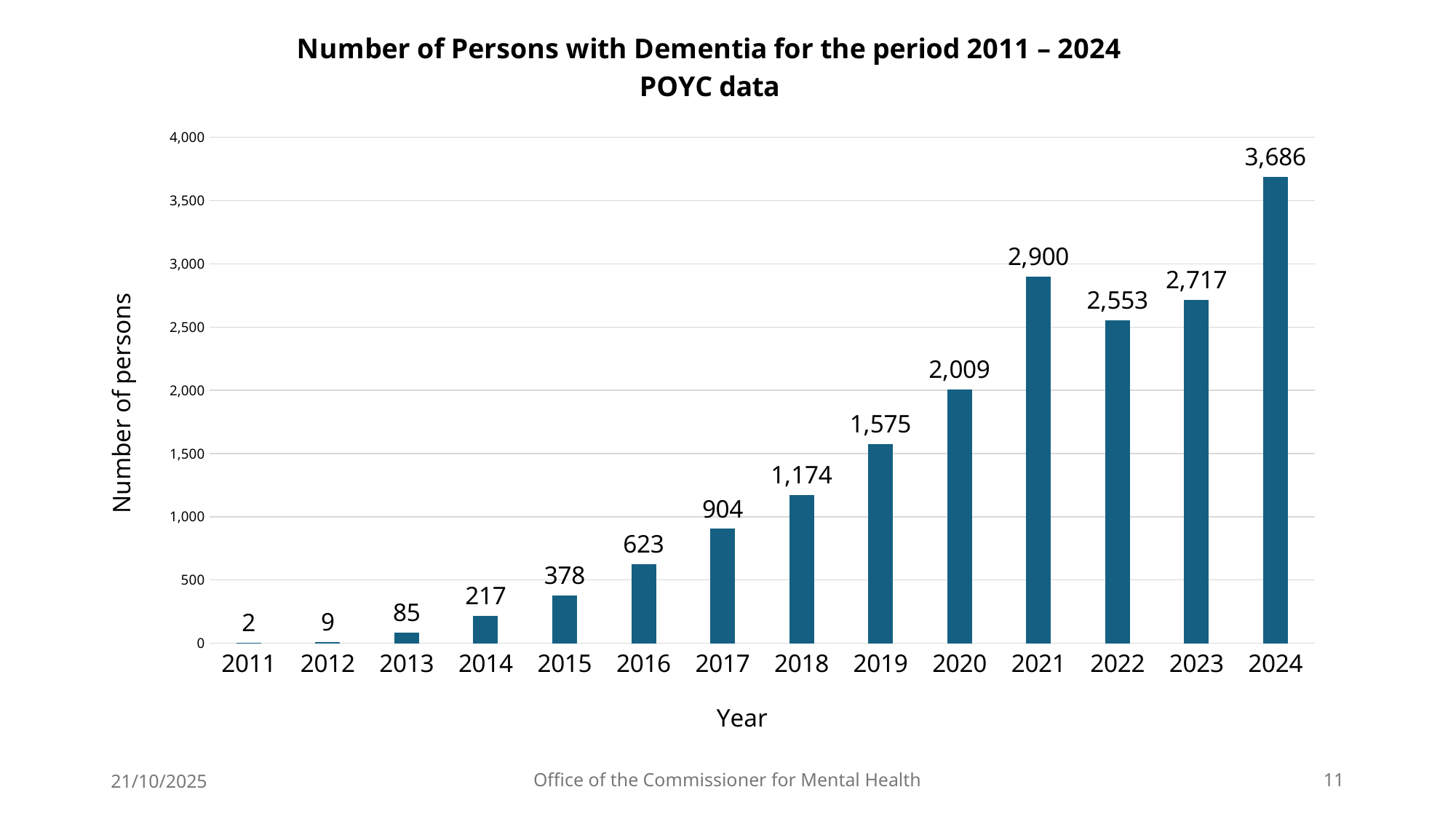
What is the difference between the number of persons with dementia in 2024 and in 2023? 969 Is the value for 2020 greater or less than 1,500? greater Which year has the lowest number of persons with dementia? 2011 What is the number of persons with dementia in 2019? 1,575 How many years are shown on the x axis of the chart? 14 What is the label of the y axis of the chart? Number of persons What is the number of persons with dementia in 2022? 2,553 What kind of chart is shown on the slide? Bar chart What is the number of persons with dementia in 2013? 85 Which year has a larger number of persons with dementia, 2021 or 2023? 2021 What is the difference between the number of persons with dementia in 2021 and in 2022? 347 Which year has the highest number of persons with dementia? 2024